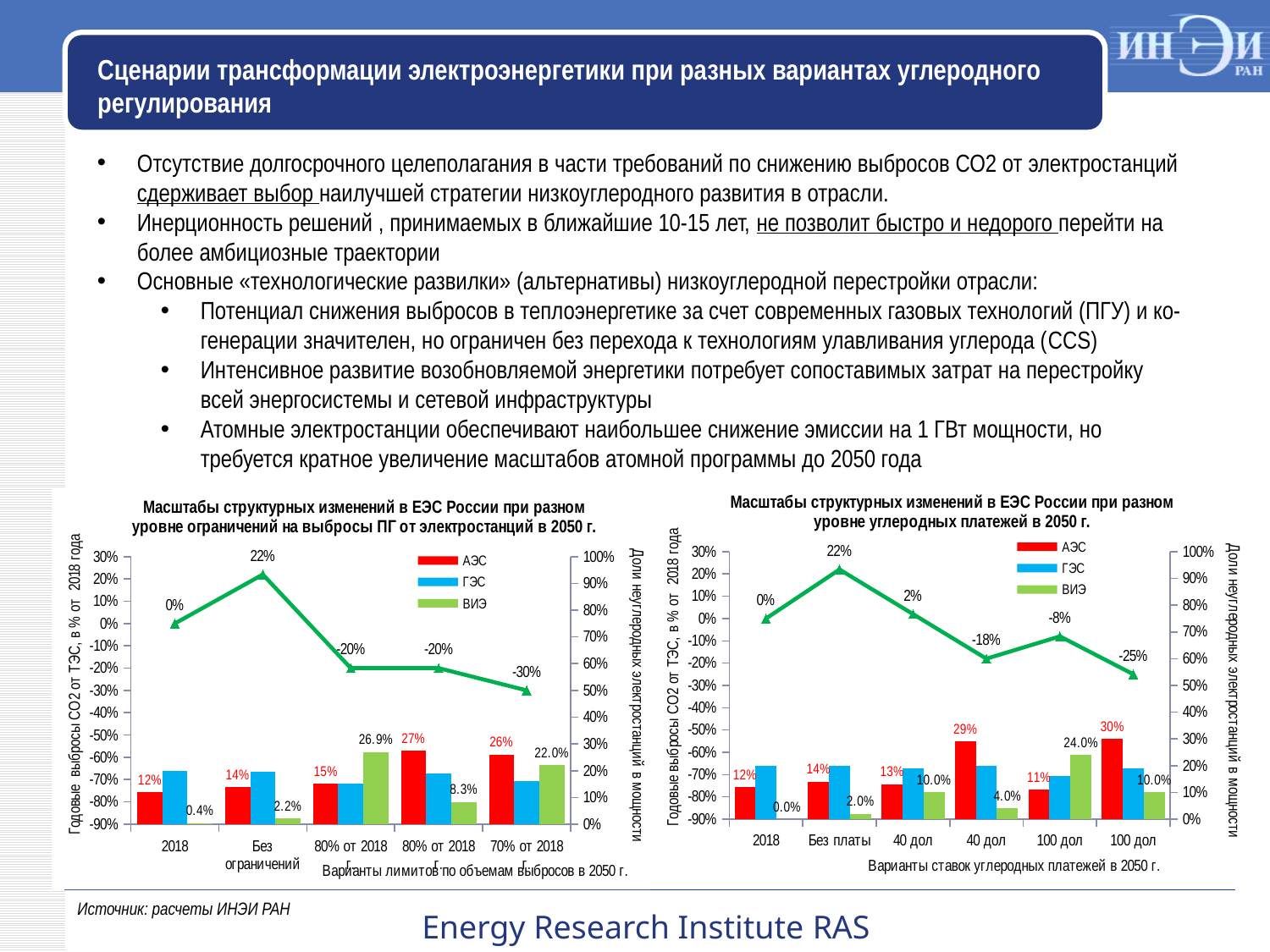
On the left chart (ограничения на выбросы), what is the line value (annual CO2 emissions change) for the '70% от 2018' scenario? -30% How many series does the legend of the right chart (углеродные платежи) list? 3 On the right chart (углеродные платежи), how many scenario categories are shown on the x axis? 6 On the left chart (ограничения на выбросы), how many scenario categories are shown on the x axis? 5 On the right chart (углеродные платежи), what is the lowest line value shown? -25% On the right chart (углеродные платежи), what is the line value for the 'Без платы' scenario? 22% On the left chart (ограничения на выбросы), what is the ВИЭ share label for the '70% от 2018' scenario? 22.0% On the right chart (углеродные платежи), what is the difference between the highest ВИЭ label (24.0%) and the ВИЭ label for 'Без платы' (2.0%)? 22.0% On the left chart (ограничения на выбросы), what is the АЭС share label for the 'Без ограничений' scenario? 14% On the left chart (ограничения на выбросы), which scenario has the highest line value for annual CO2 emissions change? Без ограничений On the right chart (углеродные платежи), what is the highest АЭС share label shown? 30% On the right chart (углеродные платежи), what is the АЭС share label for the 'Без платы' scenario? 14%